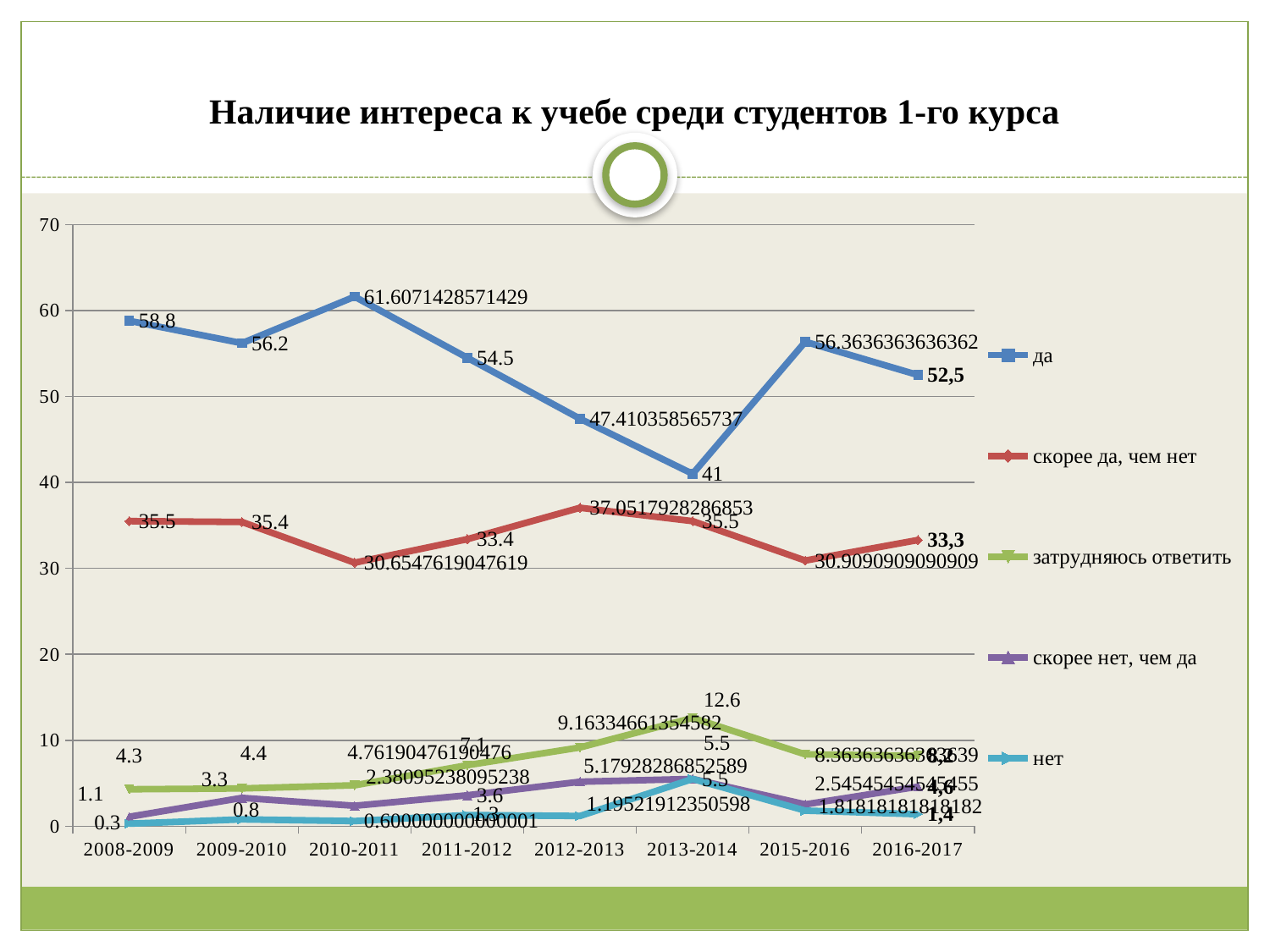
What is the difference between the "да" values for 2008-2009 and 2009-2010? 2.6 What is the value for the series "скорее да, чем нет" in 2011-2012? 33.4 In which academic year is the value for "да" the highest? 2010-2011 In which academic year is the value for "да" the lowest? 2013-2014 In 2013-2014, which series has the larger value: "да" or "скорее да, чем нет"? да What is the value for the series "да" in 2013-2014? 41 What type of chart is shown on the slide? line chart How many academic years are shown on the x axis? 8 What is the value for the series "да" in 2008-2009? 58.8 How many series does the legend list? 5 What is the title of the chart on the slide? Наличие интереса к учебе среди студентов 1-го курса In which academic year does the series "затрудняюсь ответить" reach its highest value? 2013-2014